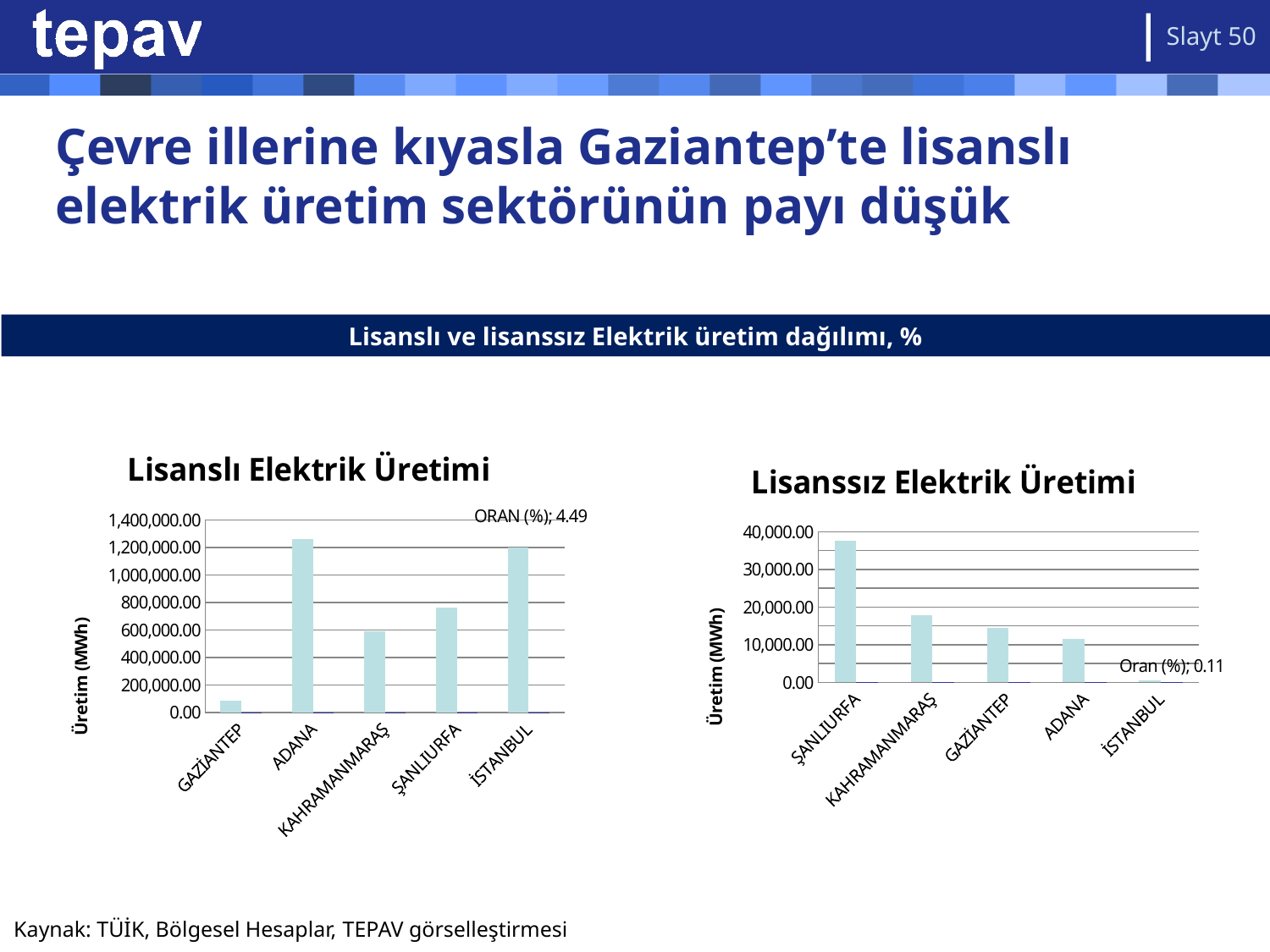
In the Lisanssız Elektrik Üretimi chart, is the value for ŞANLIURFA greater or less than 30,000.00? greater What kind of chart is the Lisanssız Elektrik Üretimi chart? bar chart In the Lisanslı Elektrik Üretimi chart, which province has the lowest production? GAZİANTEP In the Lisanslı Elektrik Üretimi chart, which province has the highest production? ADANA How many provinces are shown in the Lisanslı Elektrik Üretimi chart? 5 In the Lisanslı Elektrik Üretimi chart, is the value for GAZİANTEP greater or less than 200,000.00? less In the Lisanssız Elektrik Üretimi chart, which province has the lowest production? İSTANBUL In the Lisanslı Elektrik Üretimi chart, is the value for ADANA greater or less than 1,200,000.00? greater In the Lisanslı Elektrik Üretimi chart, which is larger, the value for İSTANBUL or the value for ŞANLIURFA? İSTANBUL In the Lisanssız Elektrik Üretimi chart, do the bar values rise or fall from left to right? fall In the Lisanssız Elektrik Üretimi chart, which is larger, the value for KAHRAMANMARAŞ or the value for ADANA? KAHRAMANMARAŞ In the Lisanssız Elektrik Üretimi chart, which province has the highest production? ŞANLIURFA